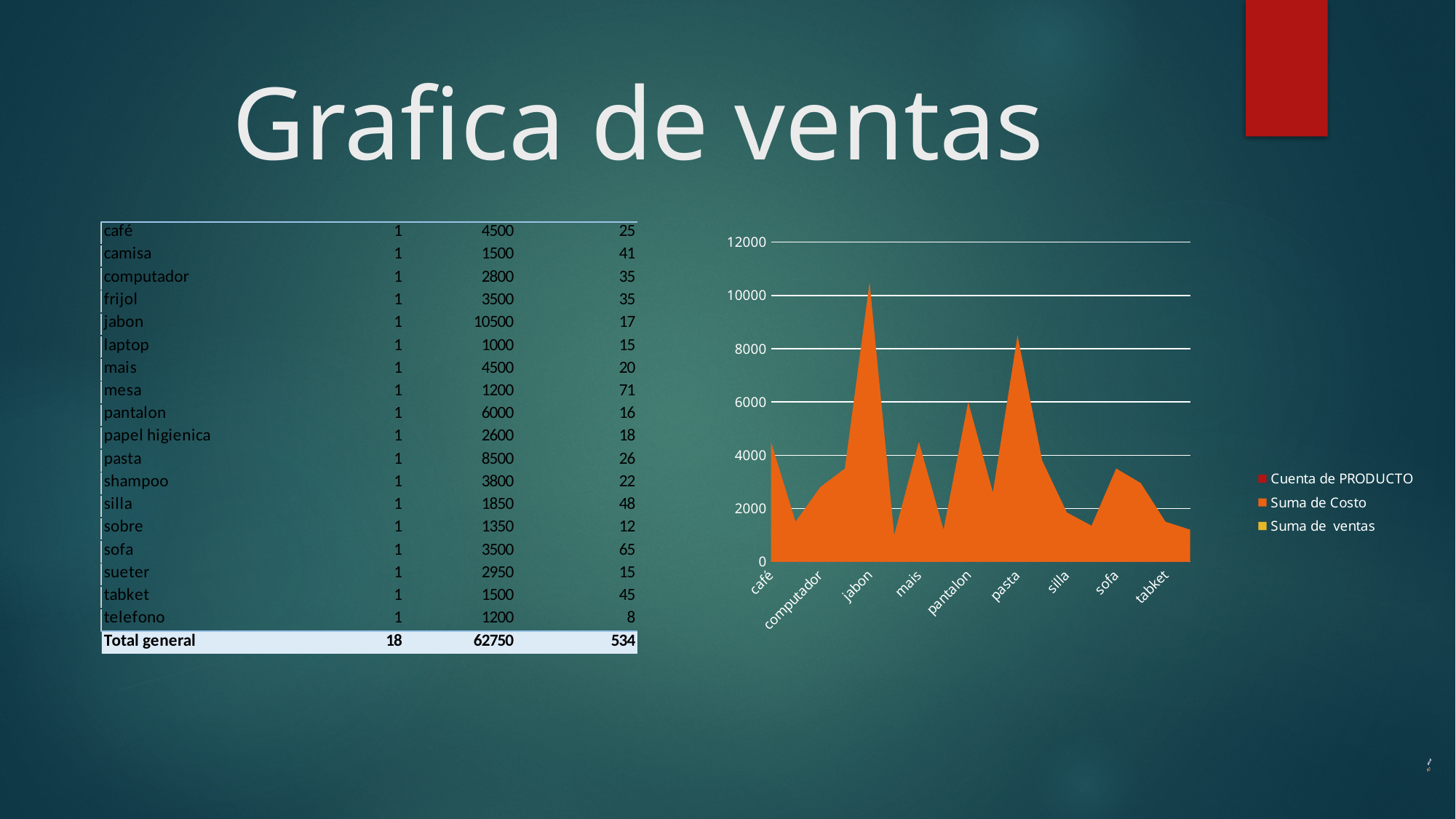
Is the value for sofa in the chart greater or less than 4000? less Which series is plotted in orange in the chart? Suma de Costo According to the table on the slide, what is the Suma de Costo value for jabon? 10500 Is the value for jabon in the chart greater or less than 8000? greater Is the value for tabket in the chart greater or less than 2000? less In the chart, which is larger, the value for jabon or the value for pasta? jabon Which category has the highest peak in the chart? jabon In the chart, which is larger, the value for café or the value for computador? café How many category labels are printed along the x axis of the chart? 9 What kind of chart is shown on the slide? area chart How many series does the chart legend list? 3